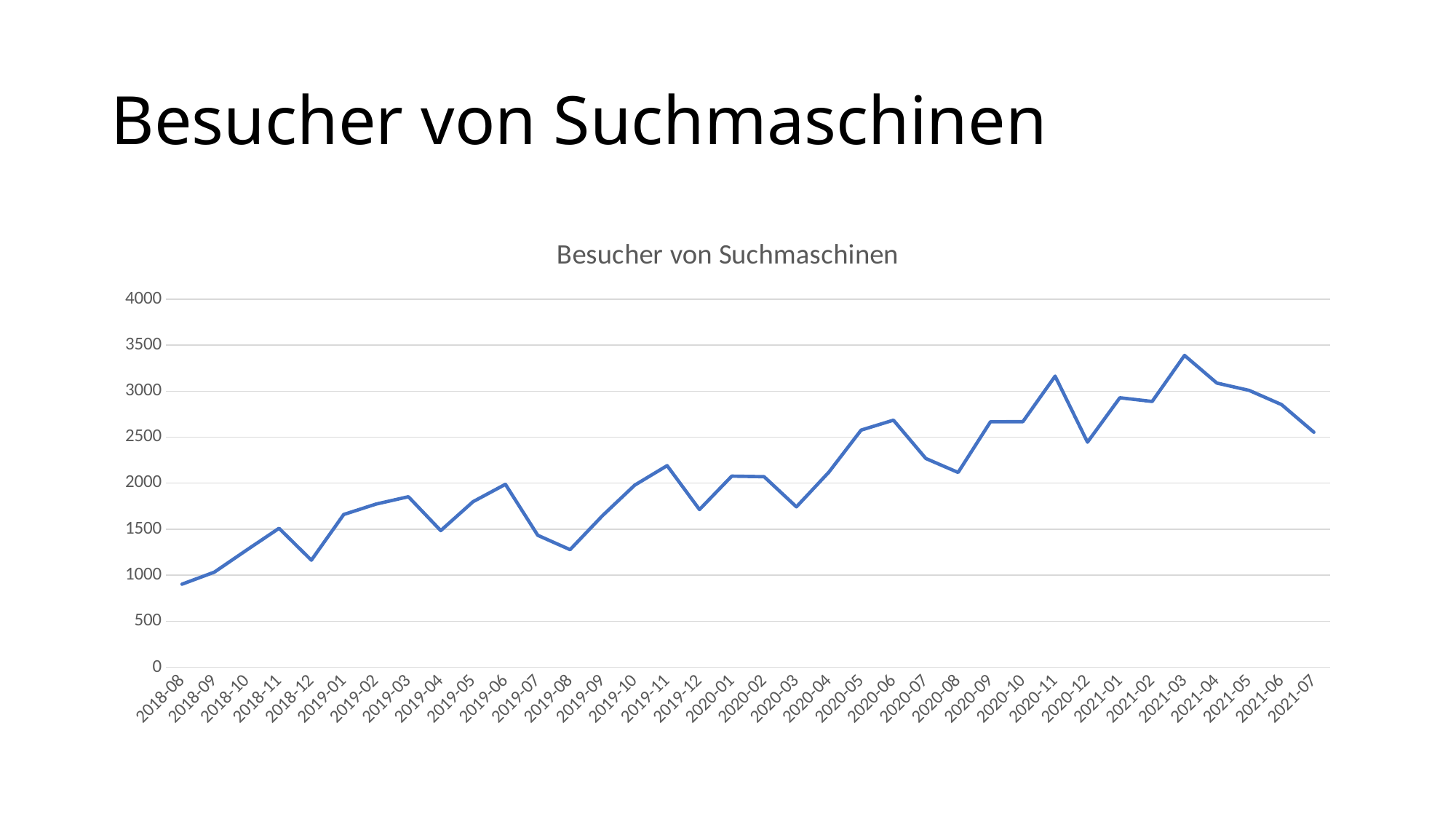
Which is larger, the value for 2020-11 or the value for 2020-12? 2020-11 How many months are plotted along the x axis? 36 What kind of chart is shown on the slide? line chart Overall, do the values rise or fall from 2018-08 to 2021-07? rise Which month has the highest value? 2021-03 Is the value for 2021-03 greater or less than 3000? greater Is the value for 2020-06 greater or less than 2500? greater Is the value for 2019-08 greater or less than 1500? less What is the title of the chart? Besucher von Suchmaschinen Which month has the lowest value? 2018-08